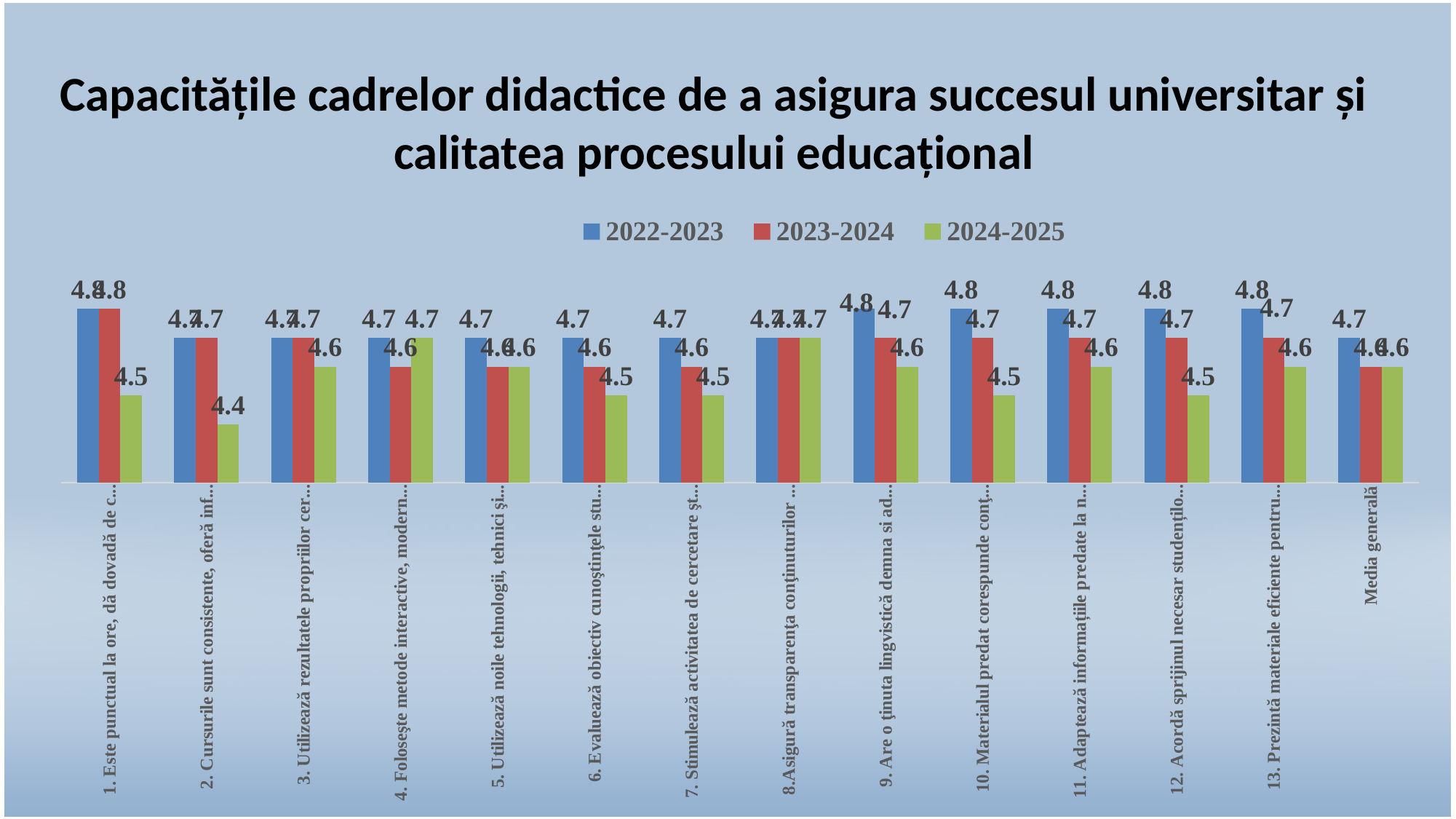
How many categories are plotted along the x axis? 14 How many series does the legend list? 3 What is the value for 'Media generală' in the 2024-2025 series? 4.6 For 'Media generală', what is the difference between the 2022-2023 value and the 2023-2024 value? 0.1 What kind of chart is shown on the slide? bar chart What is the 2023-2024 value for category 9 ('Are o ținuta lingvistică demna si ad...')? 4.7 What is the 2024-2025 value for category 2 ('Cursurile sunt consistente, oferă inf...')? 4.4 Which category has the lowest value in the 2024-2025 series? 2. Cursurile sunt consistente, oferă inf... What is the value for 'Media generală' in the 2022-2023 series? 4.7 What are the three legend entries of the chart? 2022-2023, 2023-2024, 2024-2025 In the 2024-2025 series, which is larger: the value for category 1 ('Este punctual la ore...') or category 4 ('Folosește metode interactive...')? 4. Folosește metode interactive... For category 2 ('Cursurile sunt consistente...'), what is the difference between the 2022-2023 value and the 2024-2025 value? 0.3